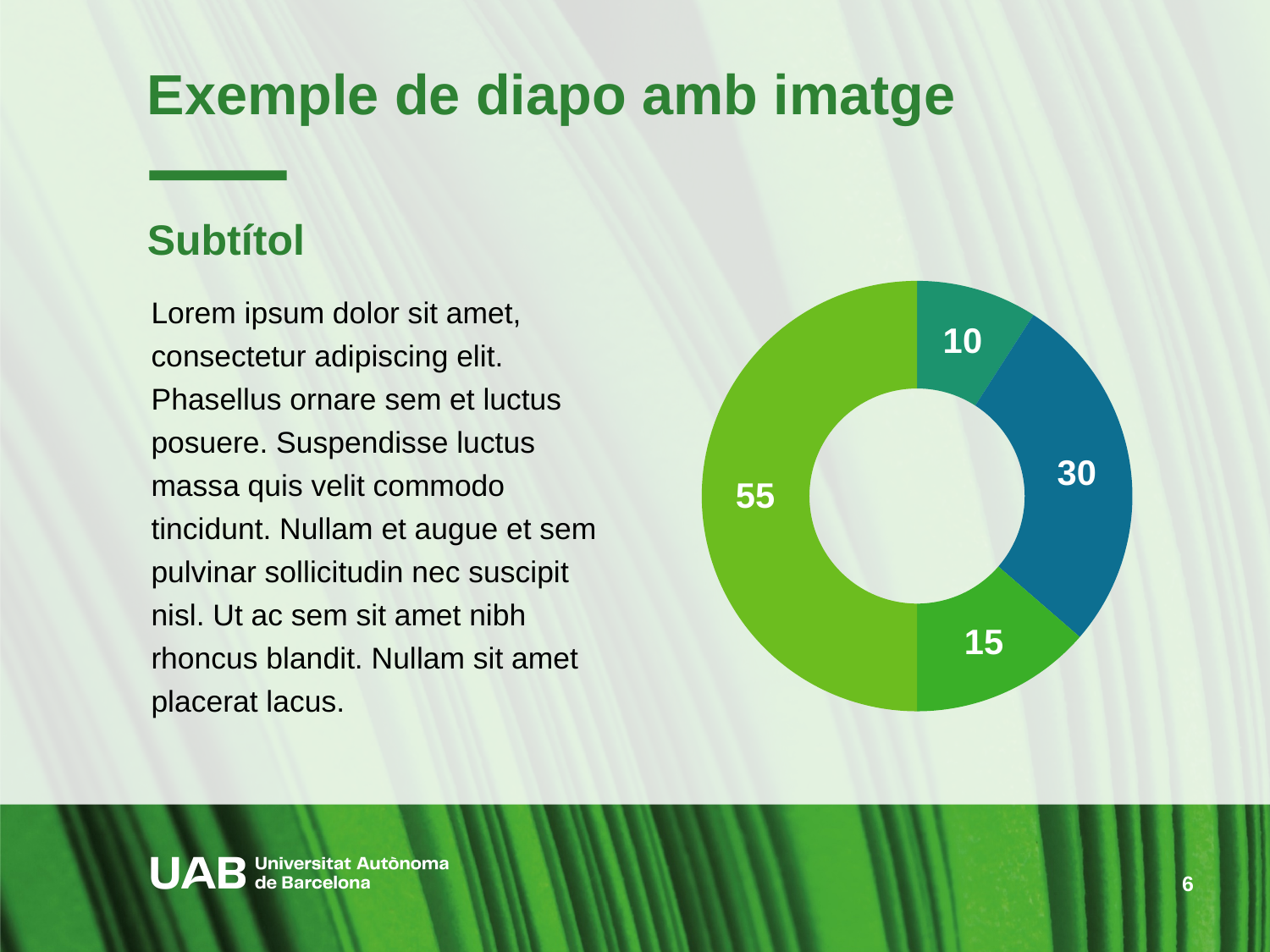
What is the total of all the values shown on the doughnut chart? 110 What is the smallest value shown on the doughnut chart? 10 Does the doughnut chart have a legend? No What share of the doughnut chart does the slice labelled 55 represent? 50% What is the difference between the largest slice (55) and the dark blue slice (30)? 25 What is the difference between the slice labelled 15 and the slice labelled 10? 5 What is the value of the dark blue slice of the doughnut chart? 30 What is the value of the light green slice of the doughnut chart? 55 What kind of chart is shown on the slide? Doughnut (pie) chart Which is larger, the dark blue slice or the teal slice at the top of the doughnut chart? The dark blue slice (30) What is the largest value shown on the doughnut chart? 55 How many slices does the doughnut chart have? 4